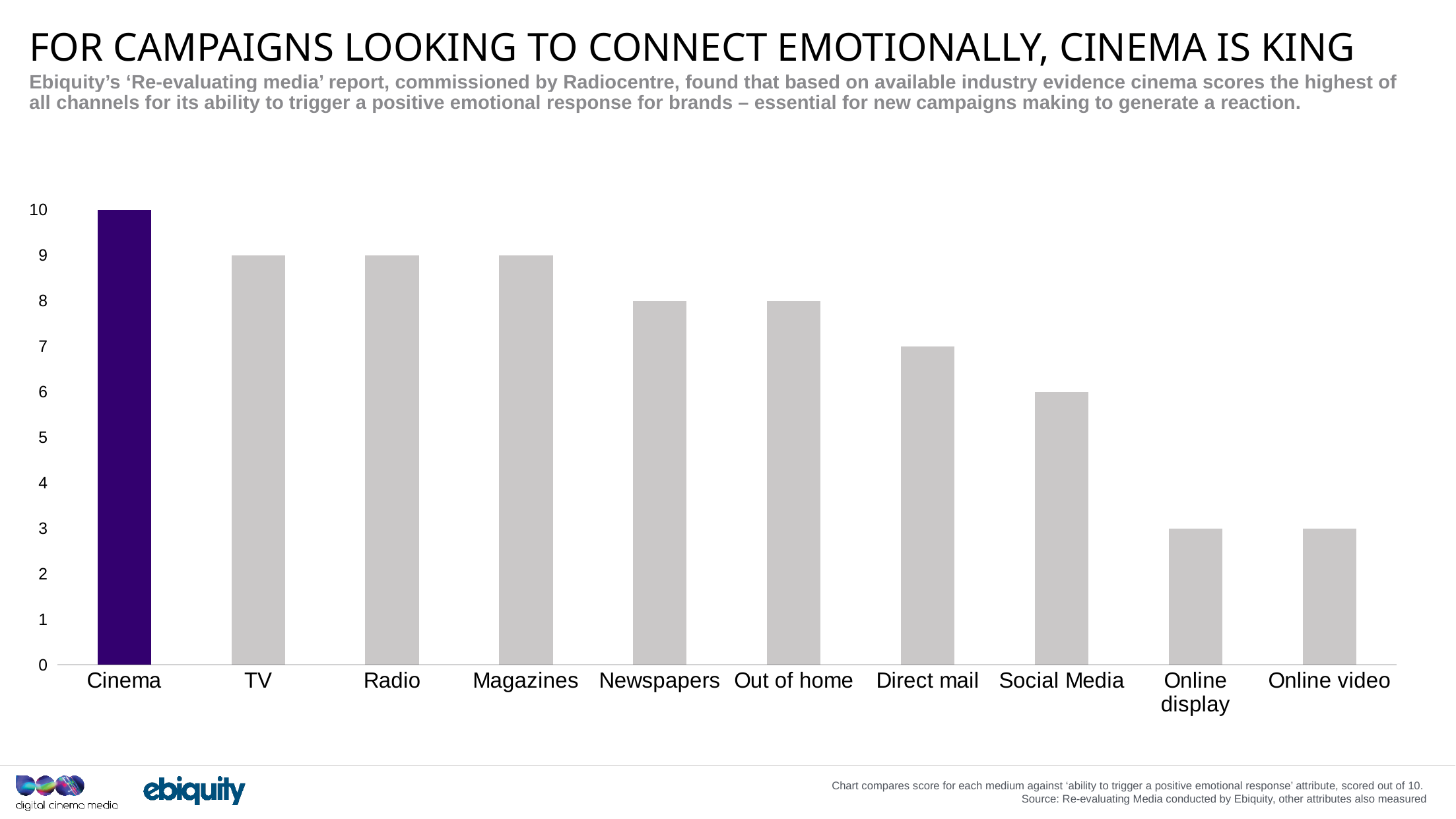
Which medium has the highest score? Cinema What is the score for Cinema? 10 What is the difference between the scores for Cinema and Social Media? 4 Do the scores rise or fall moving from left to right along the x axis? fall What kind of chart is shown on the slide? bar chart Which has a higher score, Newspapers or Direct mail? Newspapers What is the score for Social Media? 6 What is the score for Direct mail? 7 Is the score for Online video greater or less than 5? less How many media are shown on the chart? 10 What is the score for Online display? 3 Which bar is coloured purple rather than grey? Cinema